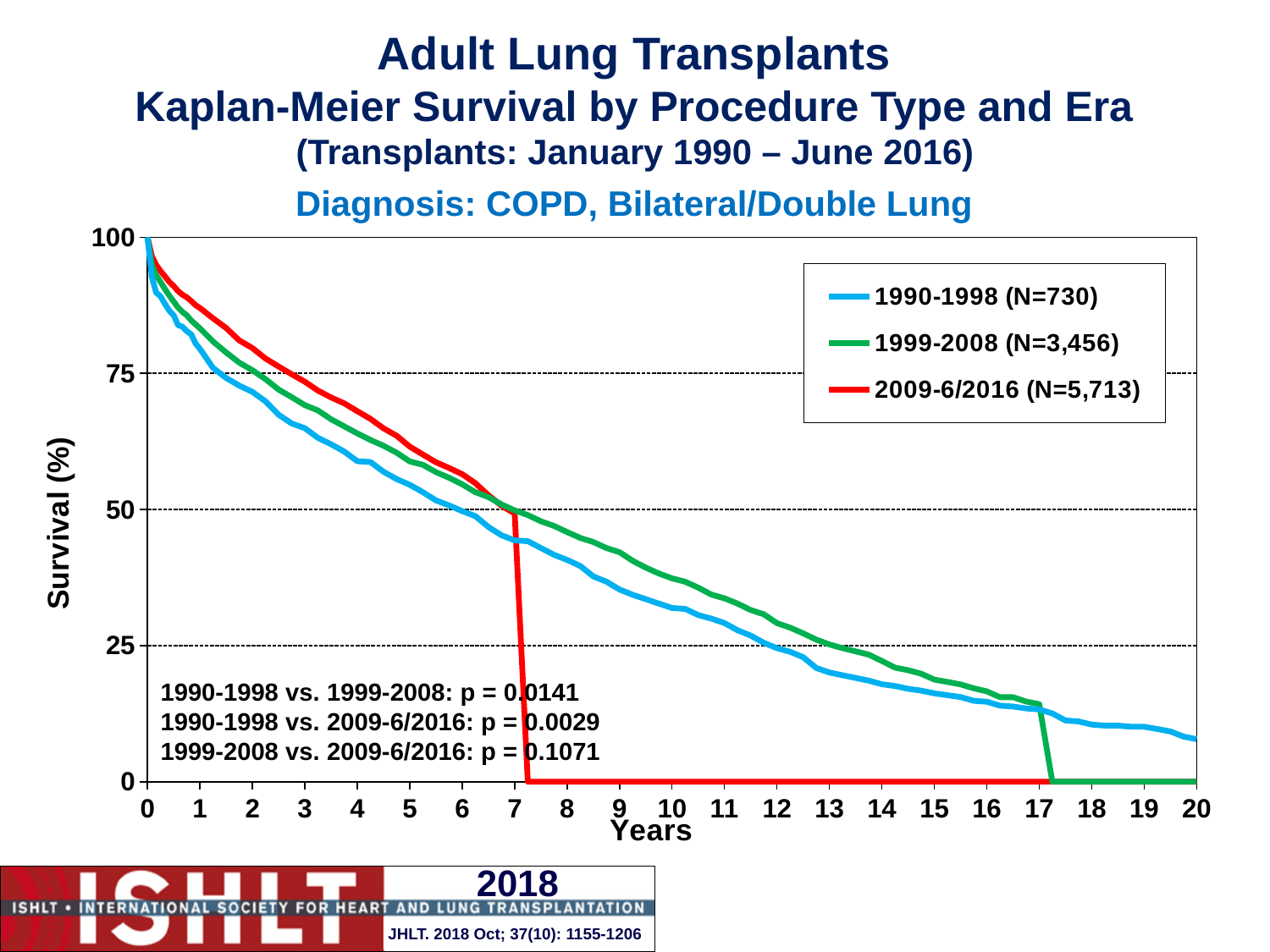
At year 3, which series has higher survival: 2009-6/2016 or 1990-1998? 2009-6/2016 How many series does the legend list? 3 Do the survival curves rise or fall as years increase? fall Which era has the lowest survival at year 10? 1990-1998 What kind of chart is shown on the slide? Line chart What p-value is shown for 1990-1998 vs. 1999-2008? p = 0.0141 At year 12, which series has higher survival: 1999-2008 or 1990-1998? 1999-2008 Is the survival for 1990-1998 at year 10 greater or less than 50? less Which era has the highest survival at year 2? 2009-6/2016 Is the survival for 1999-2008 at year 15 greater or less than 25? less What is the N for the 2009-6/2016 series in the legend? N=5,713 Is the survival for 1999-2008 at year 5 greater or less than 50? greater